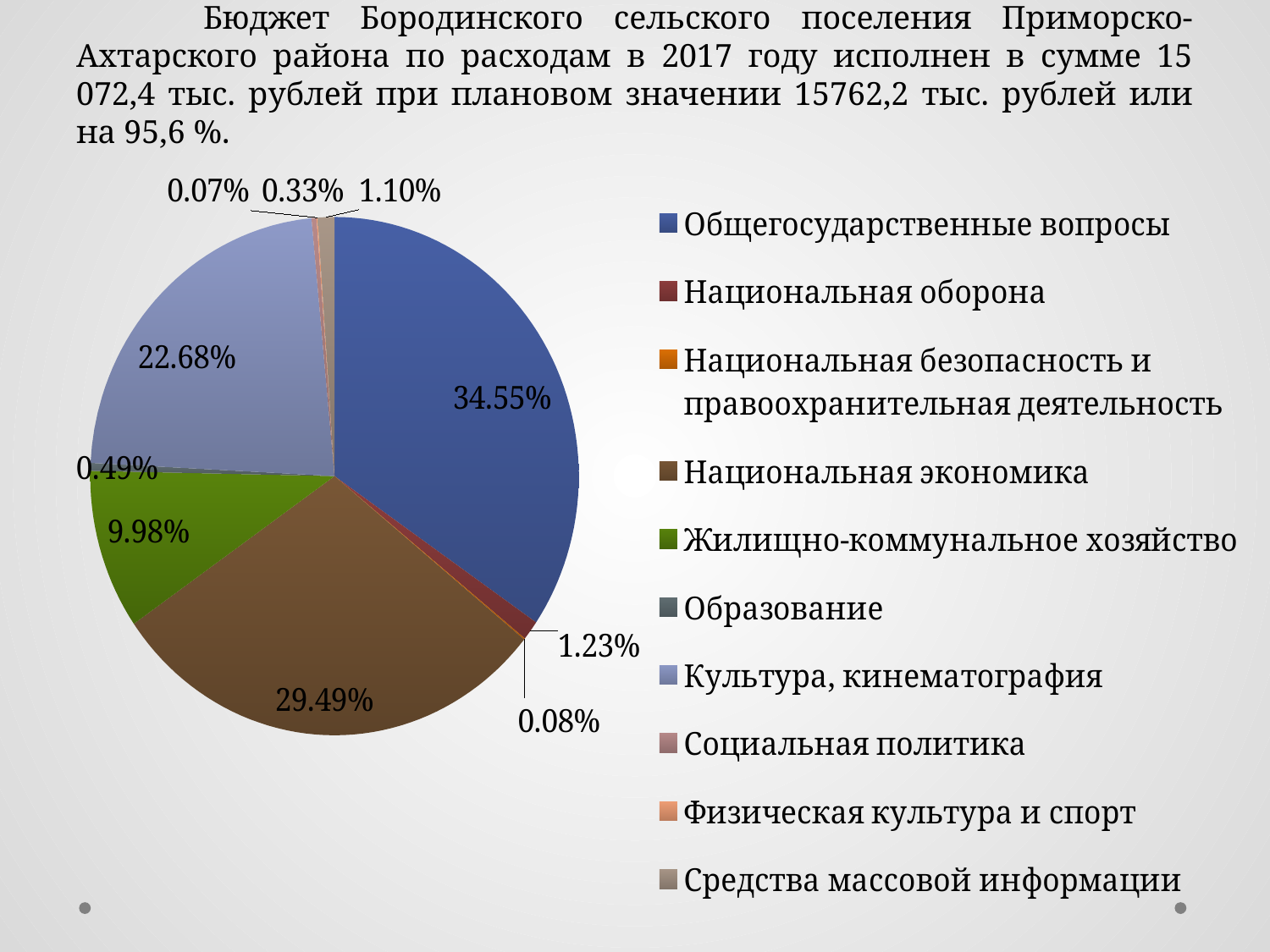
What colour is the slice for Общегосударственные вопросы? blue What share of the pie does Культура, кинематография have? 22.68% What share of the pie does Жилищно-коммунальное хозяйство have? 9.98% What kind of chart is shown on the slide? pie chart What share of the pie does Общегосударственные вопросы have? 34.55% What is the smallest percentage labelled on the pie chart? 0.07% How many categories does the legend of the pie chart list? 10 What share of the pie does Национальная оборона have? 1.23% Which slice is larger: Национальная экономика or Культура, кинематография? Национальная экономика By how many percentage points does Общегосударственные вопросы exceed Национальная экономика? 5.06 percentage points What share of the pie does Национальная экономика have? 29.49% Which category has the largest slice of the pie? Общегосударственные вопросы